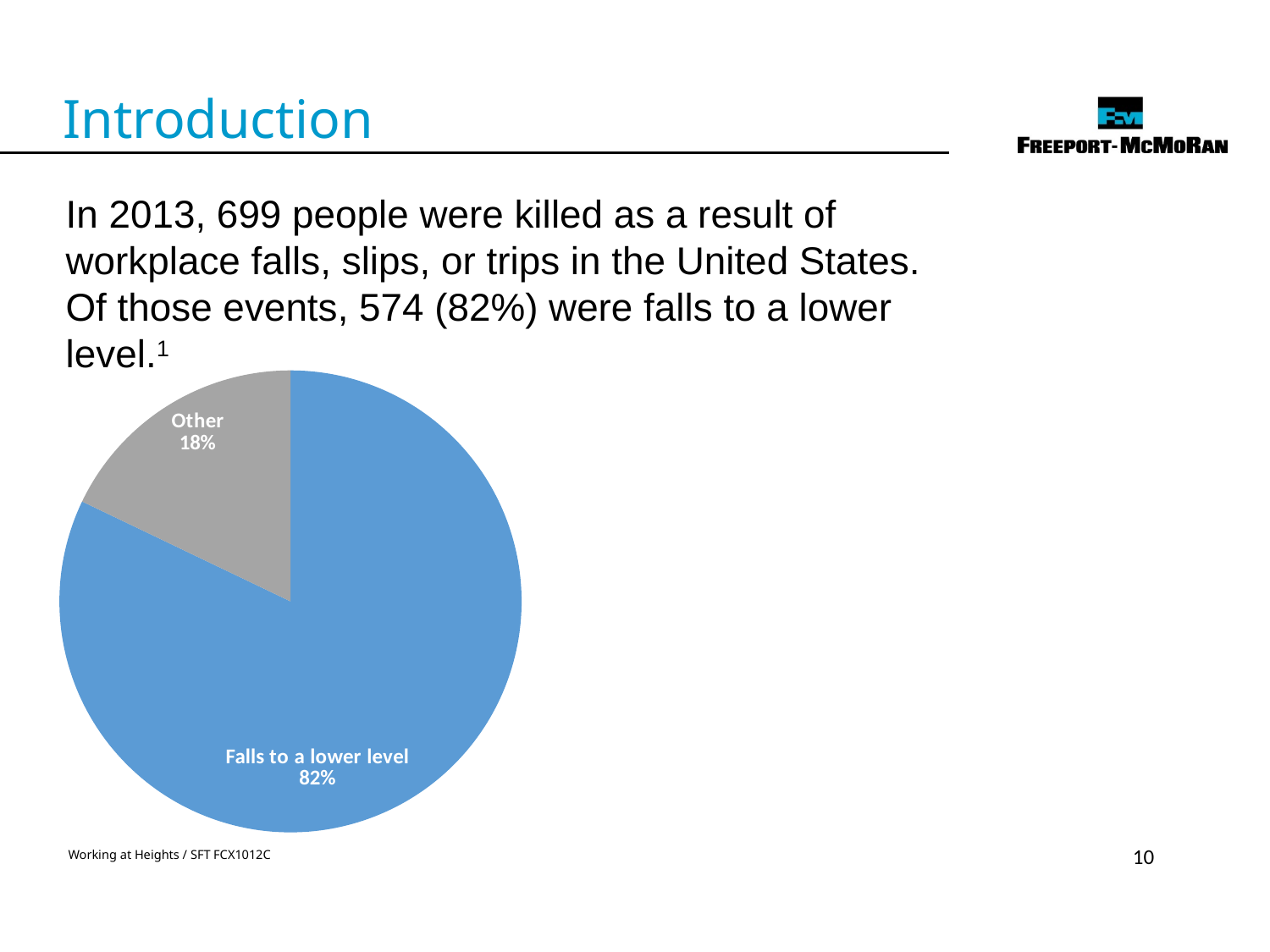
What is the difference in percentage points between the "Falls to a lower level" slice and the "Other" slice? 64 What kind of chart is shown on the slide? pie chart Which slice of the pie is the smallest? Other What colour is the "Other" slice? grey What share of the pie does "Falls to a lower level" represent? 82% Which slice of the pie is the largest? Falls to a lower level What share of the pie does "Other" represent? 18% What colour is the "Falls to a lower level" slice? blue Which is larger, the "Other" slice or the "Falls to a lower level" slice? Falls to a lower level How many slices does the pie chart have? 2